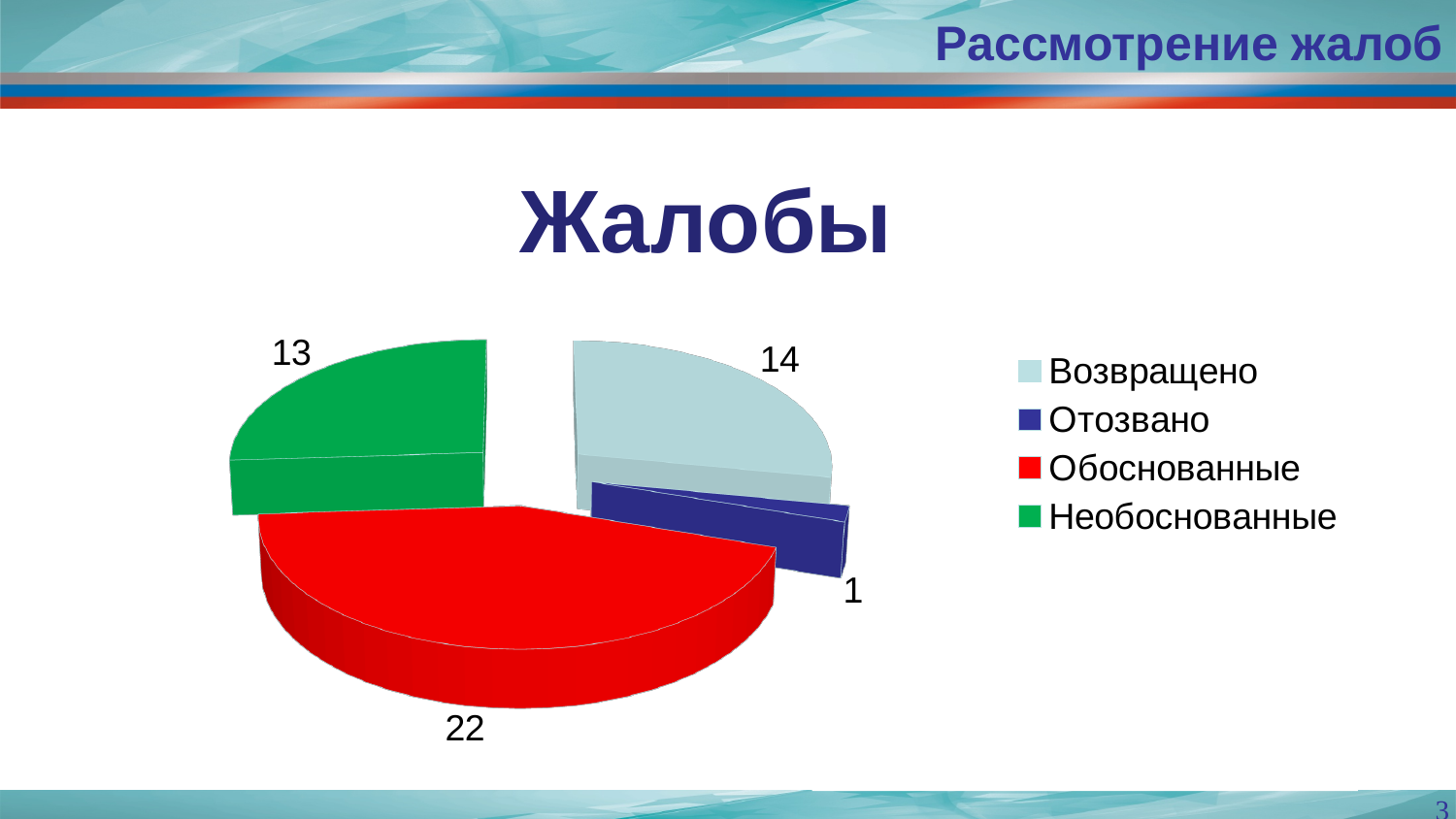
What is the value for Возвращено? 14 How many slices does the pie chart have? 4 What is the value for Обоснованные? 22 What is the title of the chart? Жалобы What type of chart is shown on the slide? Pie chart How many entries does the legend list? 4 What is the difference between the values for Обоснованные and Необоснованные? 9 What share of the pie does Обоснованные represent? 44% Which is larger, the value for Возвращено or the value for Необоснованные? Возвращено What is the value for Отозвано? 1 Which category has the largest slice? Обоснованные Which category has the smallest slice? Отозвано